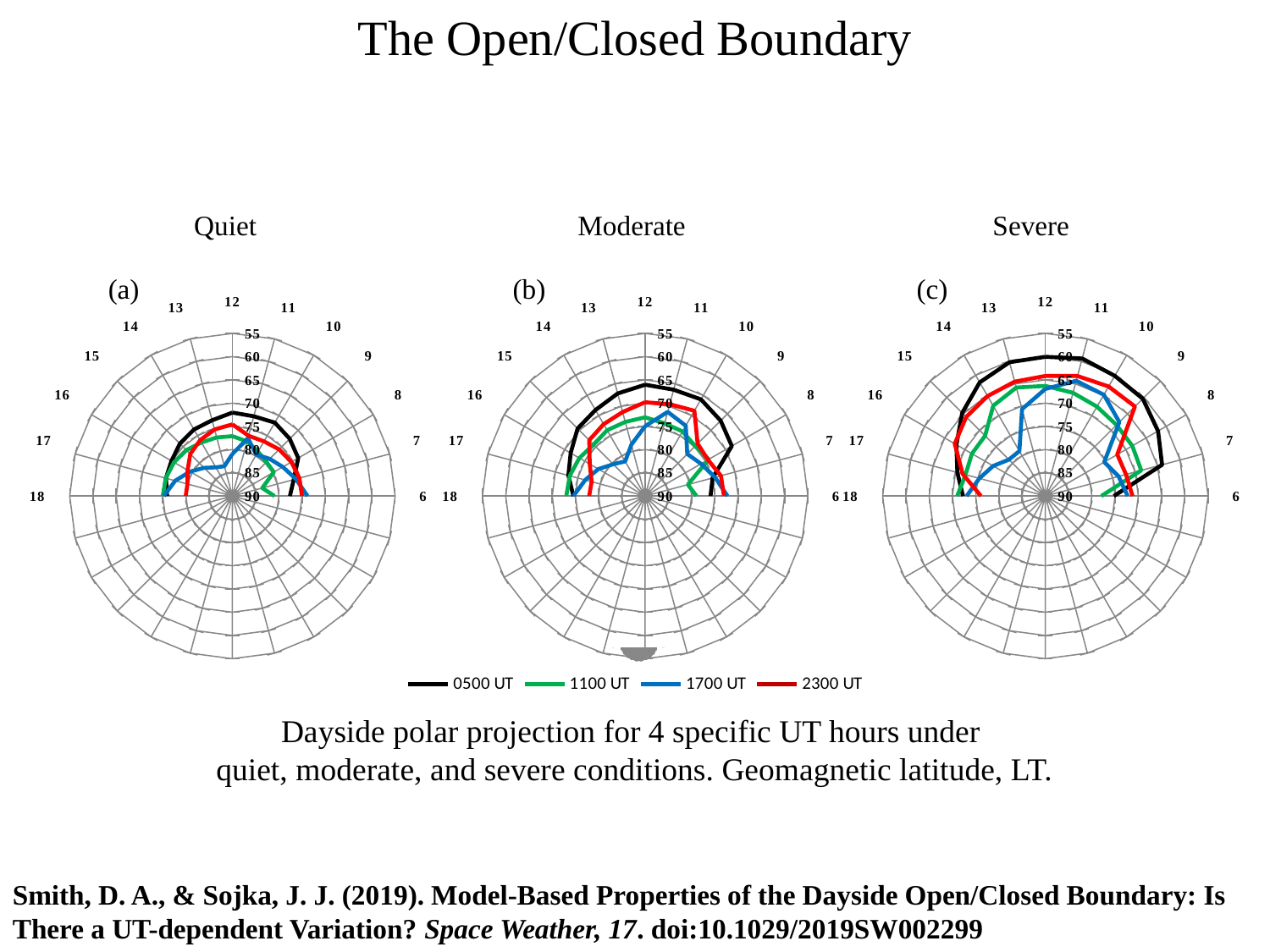
How many series does the legend list? 4 In the Moderate chart (b), which is at a lower latitude at 12 LT: the 0500 UT line or the 1700 UT line? 0500 UT How many local-time (LT) hour labels are placed around each polar chart? 13 In the Quiet chart (a), which series reaches the lowest geomagnetic latitude (outermost line) at 12 LT? 0500 UT Which UT hour is drawn in blue in the legend? 1700 UT In the Severe chart (c), which series reaches the lowest geomagnetic latitude (outermost line) at 12 LT? 0500 UT In the Quiet chart (a), is the latitude of the 0500 UT boundary at 12 LT greater or less than 65? greater Which UT hour is drawn in black in the legend? 0500 UT In the Severe chart (c), is the latitude of the 0500 UT boundary at 12 LT greater or less than 70? less What kind of chart is used for the Quiet, Moderate and Severe panels? Radar (polar) chart How many polar charts are shown on the slide? 3 In the Quiet chart (a), which series lies closest to the centre (highest latitude) at 12 LT? 1700 UT